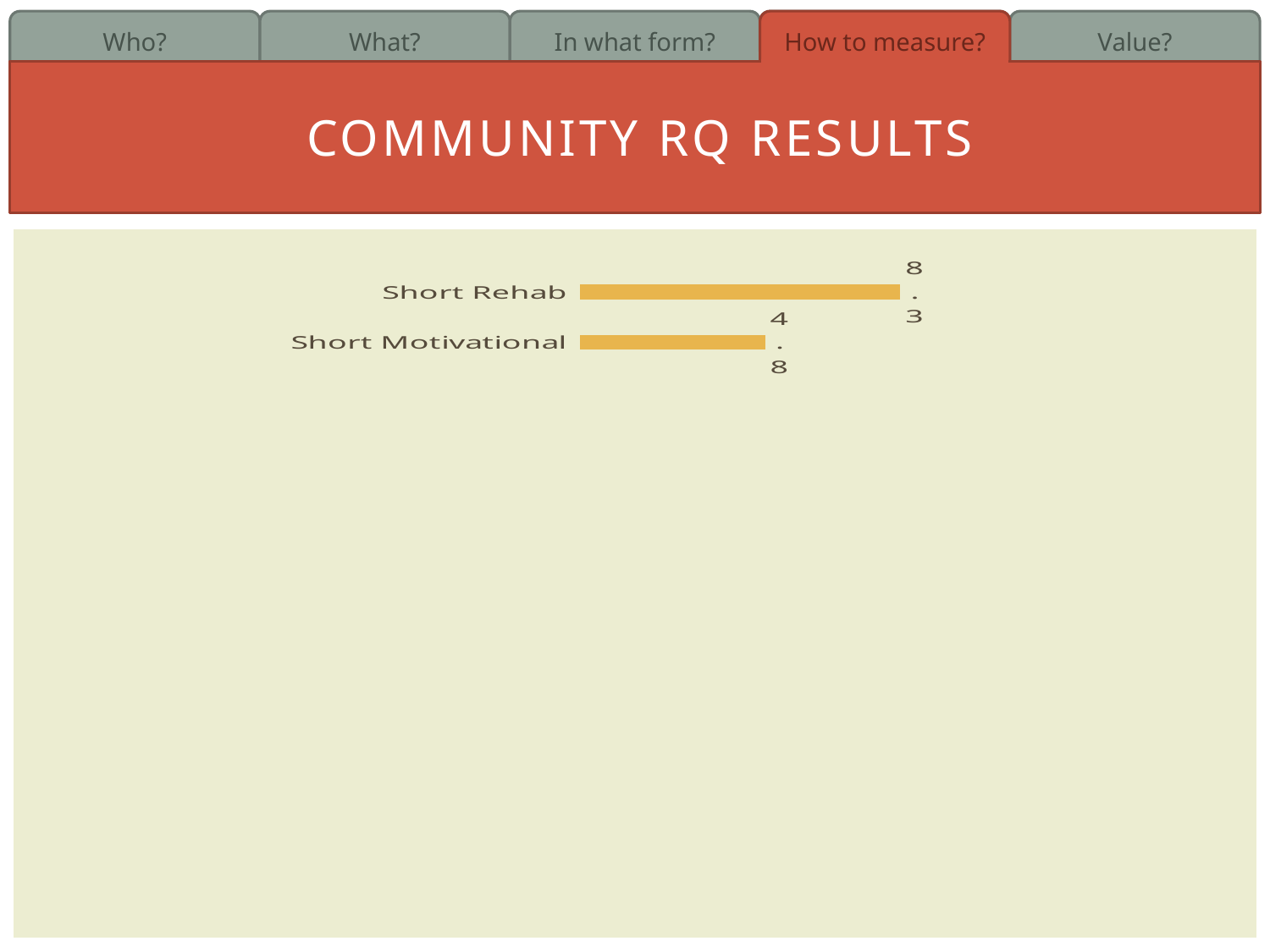
How many categories are shown in the chart? 2 What is the difference between the values for Short Rehab and Short Motivational? 3.5 What is the title of the slide containing the chart? COMMUNITY RQ RESULTS What colour are the bars in the chart? Orange What kind of chart is shown on the slide? Bar chart What is the value for Short Rehab? 8.3 Which category has the highest value? Short Rehab Which is larger, the value for Short Rehab or the value for Short Motivational? Short Rehab What is the value for Short Motivational? 4.8 Which category has the lowest value? Short Motivational